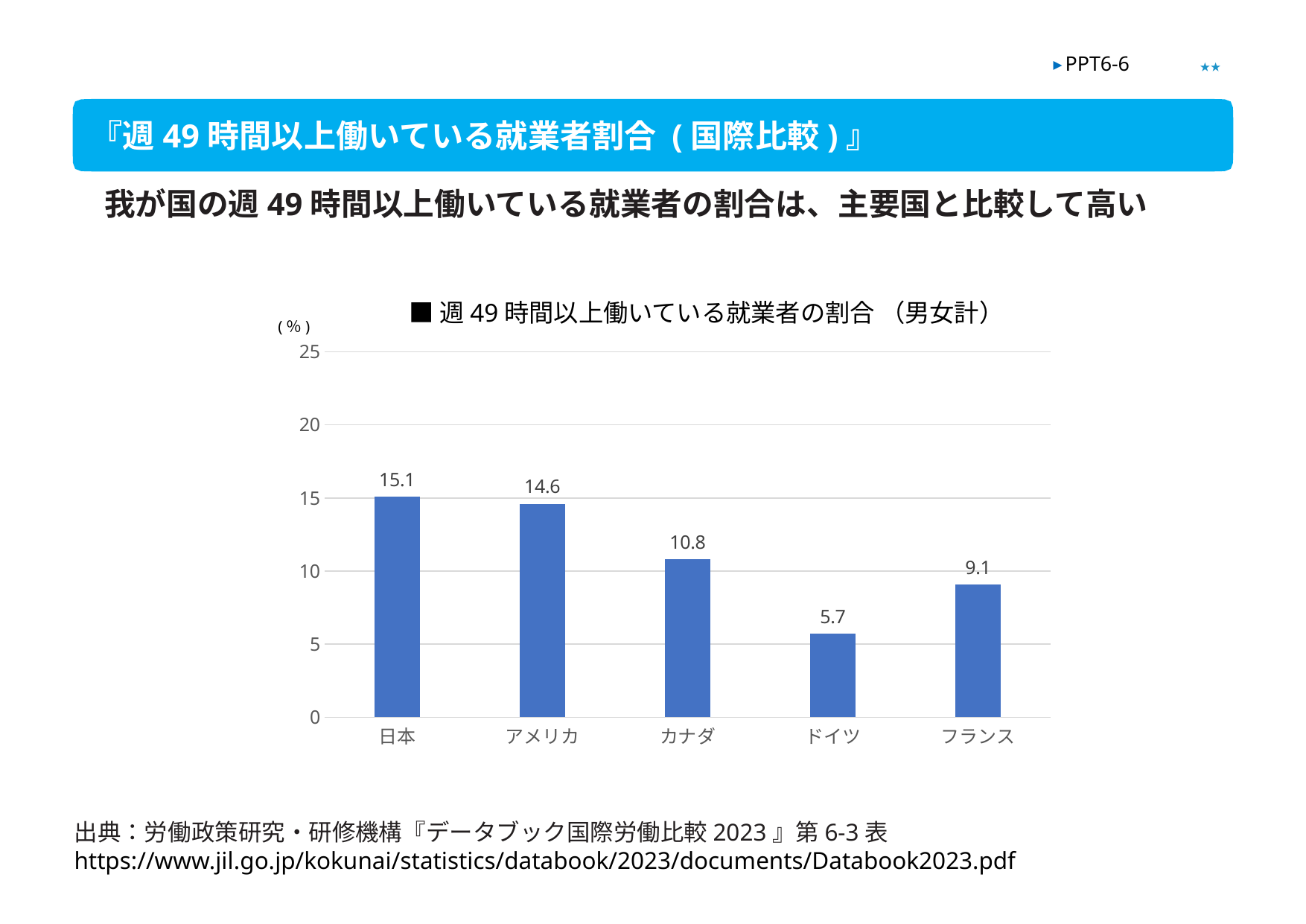
What kind of chart is shown on the slide? bar chart How many countries are shown on the chart? 5 Is the value for アメリカ greater or less than 10? greater What is the difference between the values for カナダ and フランス? 1.7 What is the value for ドイツ (Germany)? 5.7 What is the value for カナダ (Canada)? 10.8 What is the difference between the values for 日本 and アメリカ? 0.5 What unit is shown on the vertical axis of the chart? % Which is larger, the value for フランス or the value for ドイツ? フランス Which country has the highest value? 日本 What is the value for 日本 (Japan)? 15.1 Which country has the lowest value? ドイツ